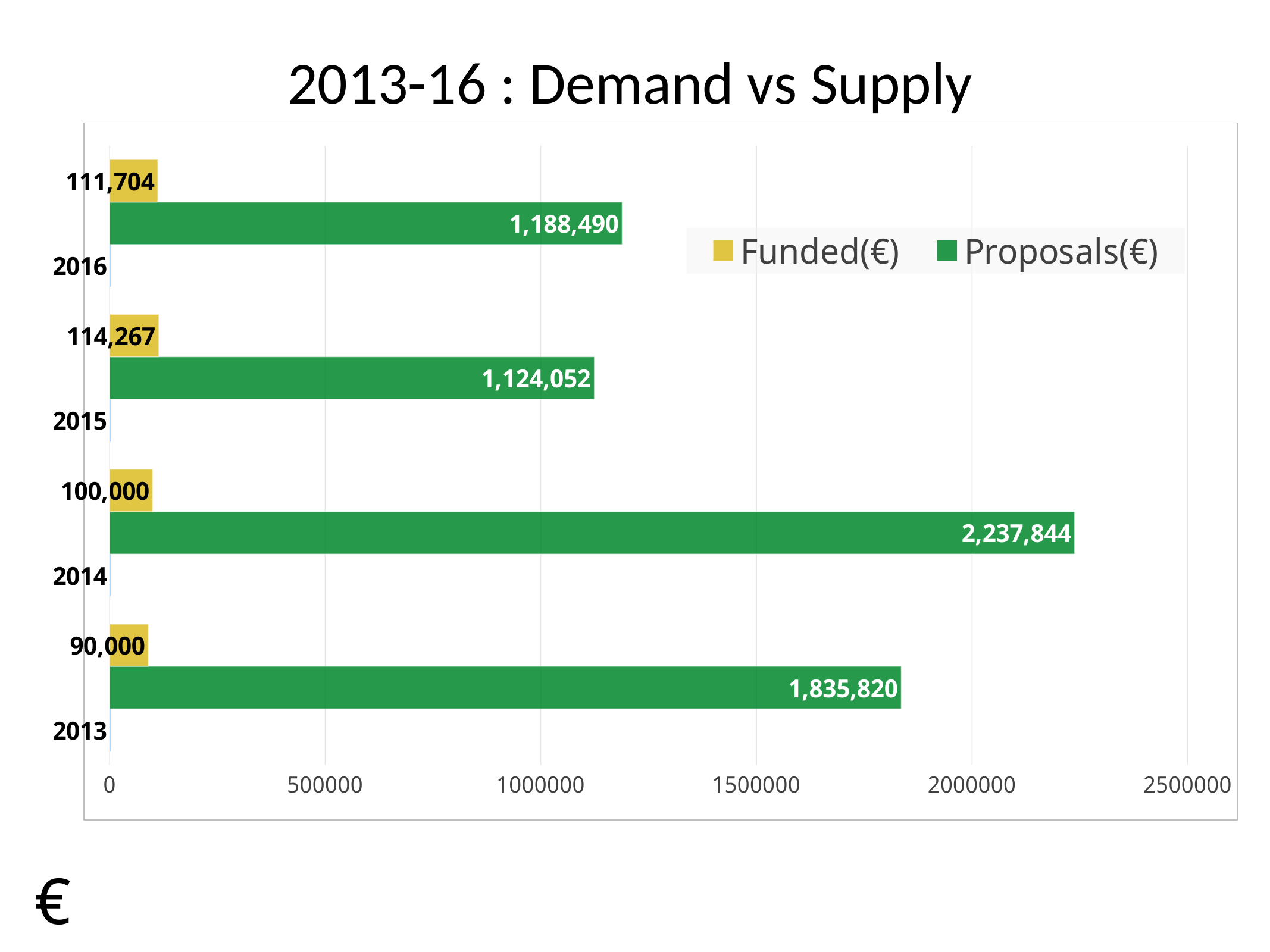
Which year has the highest Proposals(€) value? 2014 Which year has the lowest Funded(€) value? 2013 What is the difference between the Proposals(€) values for 2016 and 2015? 64,438 What is the difference between Proposals(€) and Funded(€) in 2014? 2,137,844 What is the Proposals(€) value for 2014? 2,237,844 What is the Proposals(€) value for 2015? 1,124,052 What is the Funded(€) value for 2013? 90,000 What type of chart is shown on the slide? Bar chart Which year has the highest Funded(€) value? 2015 Which is larger, the Proposals(€) value for 2013 or for 2016? 2013 How many series does the legend list? 2 What is the Funded(€) value for 2016? 111,704